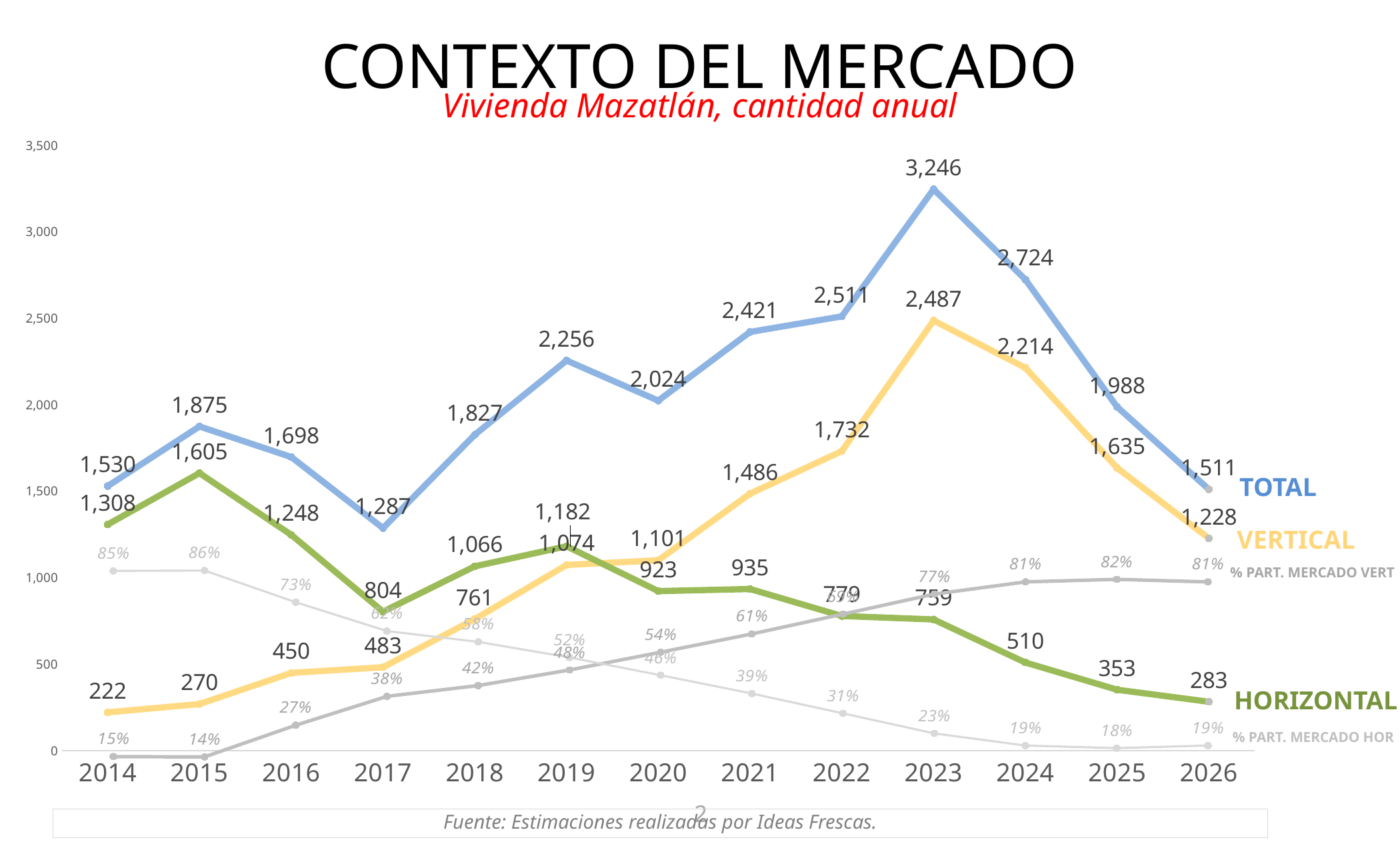
Which is larger in 2020, the VERTICAL value or the HORIZONTAL value? VERTICAL In which year does the TOTAL series reach its highest value? 2023 Does the HORIZONTAL series rise or fall from 2023 to 2026? fall How many years are shown on the x axis? 13 What kind of chart is shown on the slide? line chart Is the TOTAL value for 2017 greater or less than 1,500? less In which year is the VERTICAL series at its lowest value? 2014 What is the % PART. MERCADO VERT value for 2025? 82% What is the VERTICAL value for 2019? 1,074 What is the difference between the TOTAL values for 2023 and 2024? 522 What is the HORIZONTAL value for 2017? 804 What is the TOTAL value for 2023? 3,246